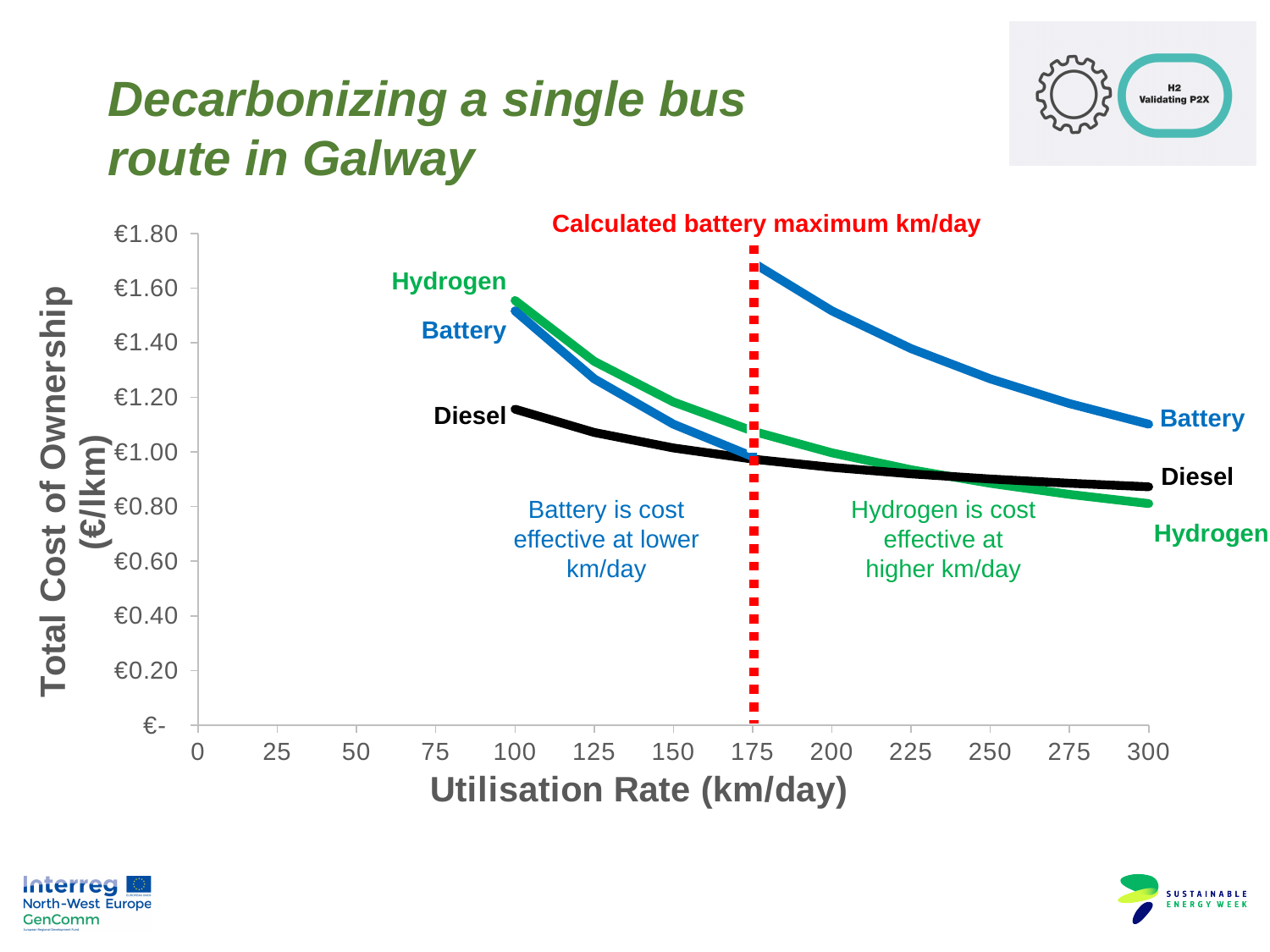
What is the title of the x axis? Utilisation Rate (km/day) At 100 km/day, which is higher, Hydrogen or Diesel? Hydrogen At 300 km/day, which is higher, Battery or Hydrogen? Battery Is the value for Hydrogen at 100 km/day greater or less than €1.40? greater Which series has the highest total cost of ownership at 300 km/day? Battery Is the value for Diesel at 100 km/day greater or less than €1.00? greater Does the Diesel line rise or fall as the utilisation rate increases? falls How many series are plotted on the chart? 3 What kind of chart is shown on the slide? line chart At what utilisation rate is the red dashed vertical line drawn? 175 Is the value for Battery at 300 km/day greater or less than €1.00? greater